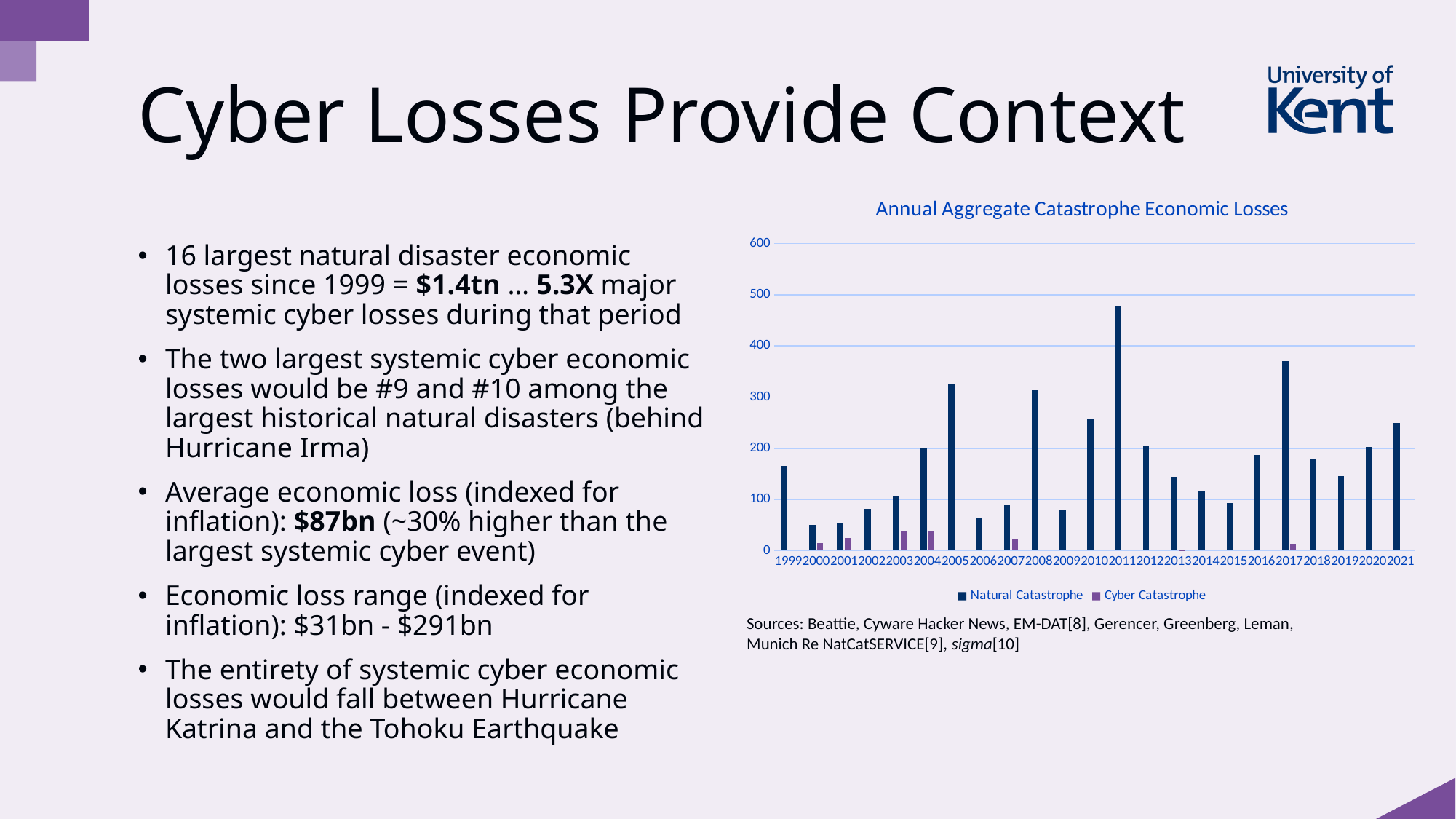
Is the Natural Catastrophe value for 2000 greater or less than 100? less What type of chart is shown on the slide? Bar chart Which is larger, the Natural Catastrophe value for 2005 or for 2010? 2005 Is the Natural Catastrophe value for 2005 greater or less than 300? greater Is the Natural Catastrophe value for 2011 greater or less than 400? greater What is the title of the chart? Annual Aggregate Catastrophe Economic Losses How many years are shown along the x axis of the chart? 23 Which year has the highest Natural Catastrophe value? 2011 Which two series are listed in the chart's legend? Natural Catastrophe and Cyber Catastrophe Which is larger, the Natural Catastrophe value for 2011 or for 2017? 2011 How many series does the chart's legend list? 2